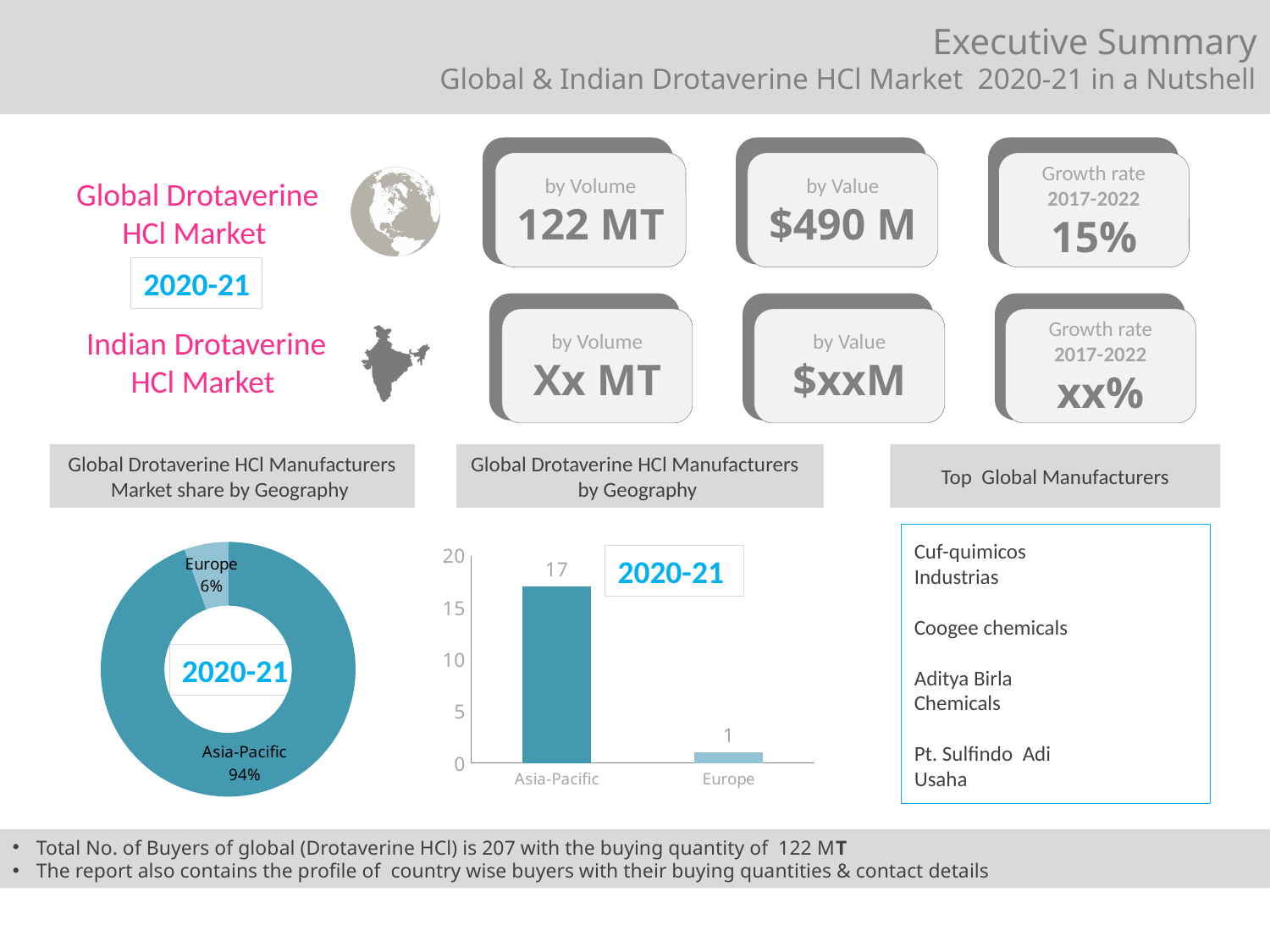
What kind of chart is the 'Global Drotaverine HCl Manufacturers by Geography' chart? Bar chart In the 'Global Drotaverine HCl Manufacturers by Geography' bar chart, what is the value for Europe? 1 In the 'Global Drotaverine HCl Manufacturers by Geography' bar chart, is the value for Asia-Pacific greater or less than 15? greater In the 'Global Drotaverine HCl Manufacturers by Geography' bar chart, how many categories are shown on the x axis? 2 What kind of chart is the 'Global Drotaverine HCl Manufacturers Market share by Geography' chart? Doughnut chart In the 'Global Drotaverine HCl Manufacturers Market share by Geography' chart, what share does Europe hold? 6% In the 'Global Drotaverine HCl Manufacturers by Geography' bar chart, which category has the highest value? Asia-Pacific In the 'Global Drotaverine HCl Manufacturers by Geography' bar chart, which category has the lowest value? Europe In the 'Global Drotaverine HCl Manufacturers Market share by Geography' chart, what share does Asia-Pacific hold? 94% In the 'Global Drotaverine HCl Manufacturers Market share by Geography' chart, which region has the larger share, Asia-Pacific or Europe? Asia-Pacific In the 'Global Drotaverine HCl Manufacturers by Geography' bar chart, what is the value for Asia-Pacific? 17 In the 'Global Drotaverine HCl Manufacturers by Geography' bar chart, what is the difference between the values for Asia-Pacific and Europe? 16